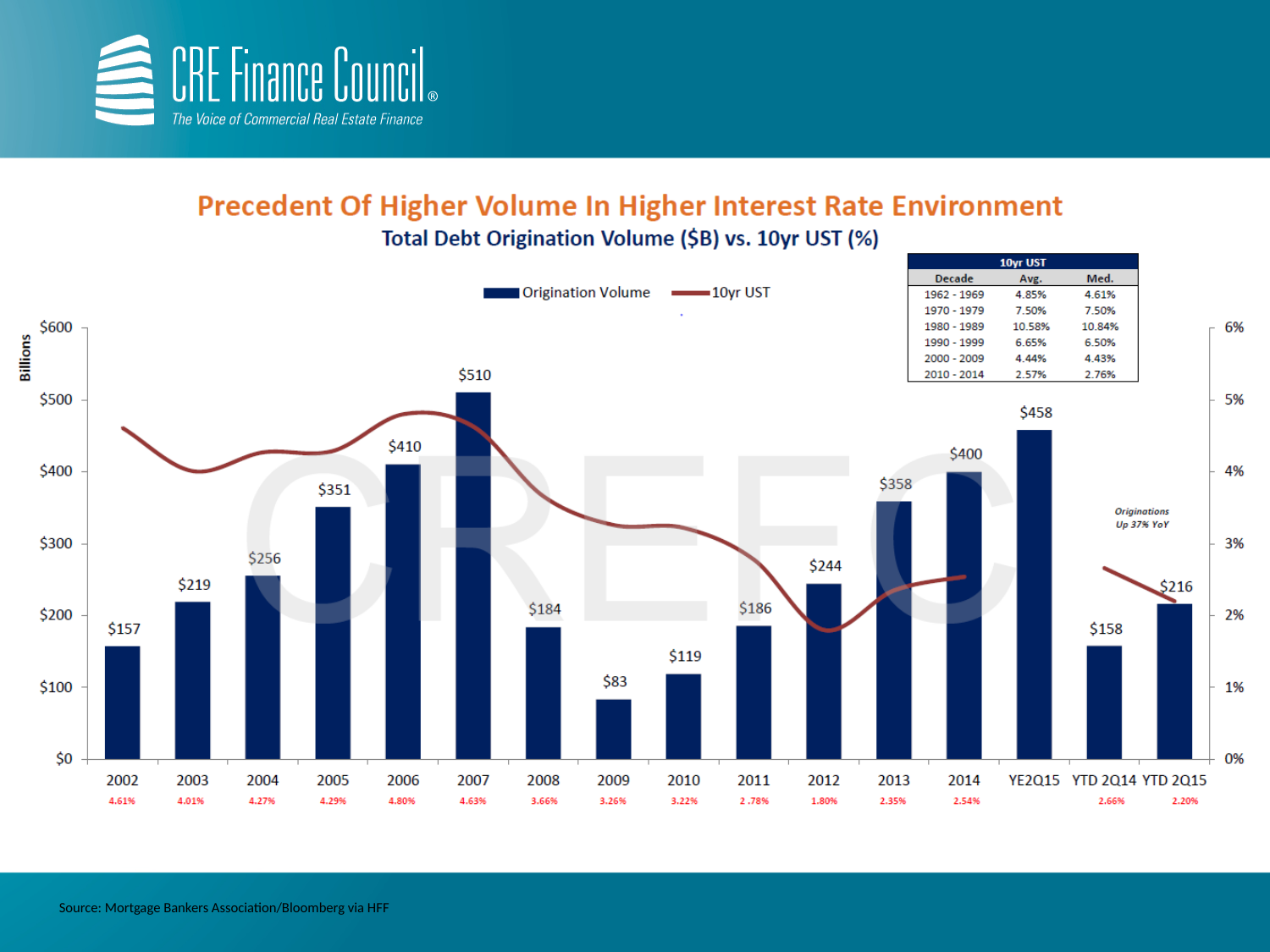
What is the 10yr UST value shown for 2012? 1.80% Is the origination volume for 2010 greater or less than $100? greater How many categories are shown on the x axis? 16 Which year has the lowest origination volume? 2009 What kind of chart is used to show origination volume? bar chart What is the origination volume for YTD 2Q15? $216 Which year has the highest origination volume? 2007 What is the origination volume for 2007? $510 What is the difference in origination volume between 2014 and 2013? $42 Does origination volume rise or fall from 2002 to 2007? rise How many series does the legend list? 2 Which has the larger origination volume, 2006 or YE2Q15? YE2Q15